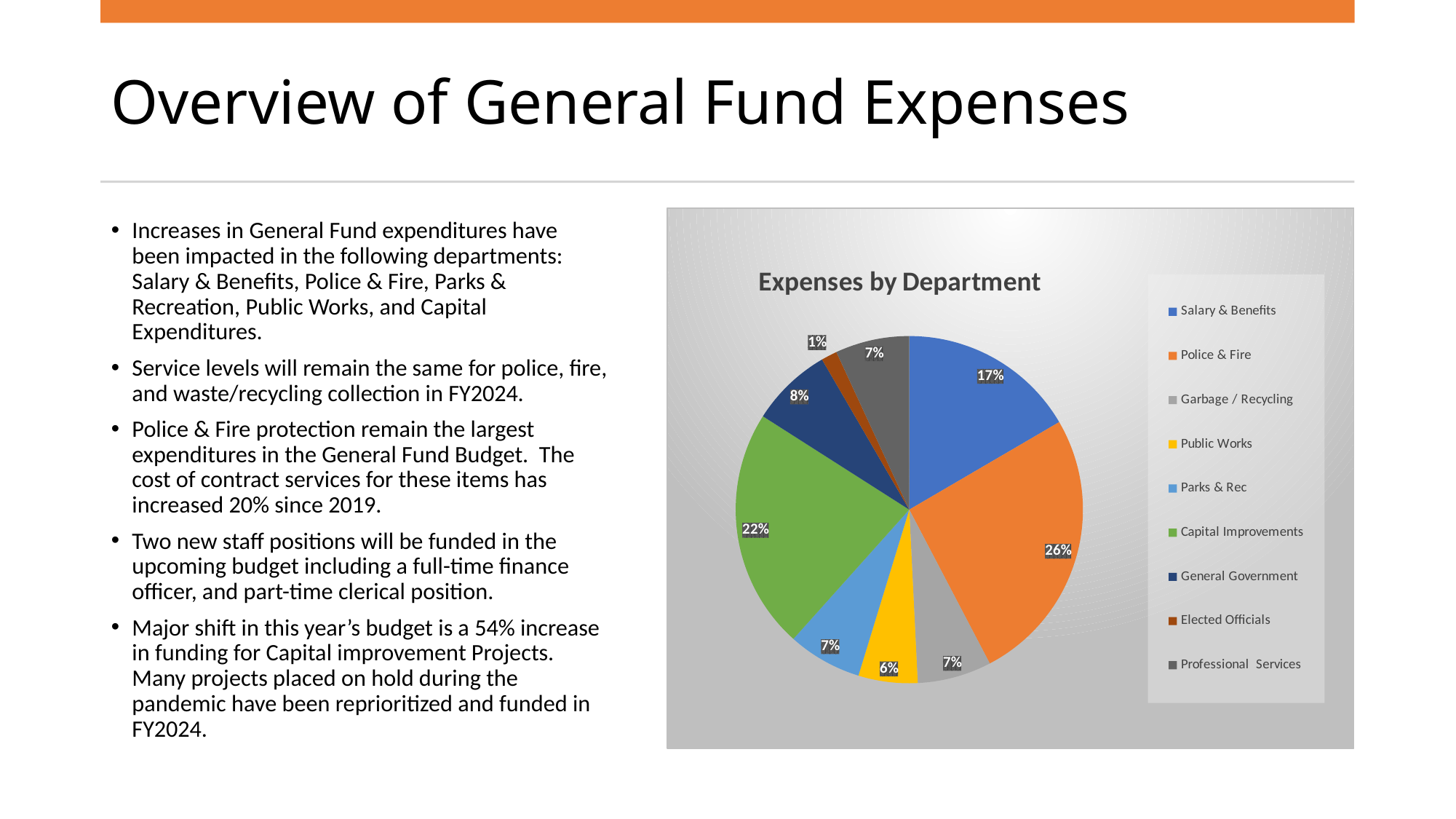
What share of expenses does Police & Fire account for? 26% What is the value shown for Salary & Benefits? 17% Which is larger, the share for Capital Improvements or the share for Salary & Benefits? Capital Improvements What is the value shown for Public Works? 6% What is the value shown for General Government? 8% What is the difference in percentage points between Police & Fire and Salary & Benefits? 9 What share of expenses does Capital Improvements account for? 22% How many categories does the legend of the pie chart list? 9 What is the title of the chart? Expenses by Department What type of chart is shown on the slide? Pie chart Which department has the smallest share of expenses? Elected Officials Which department has the largest share of expenses? Police & Fire